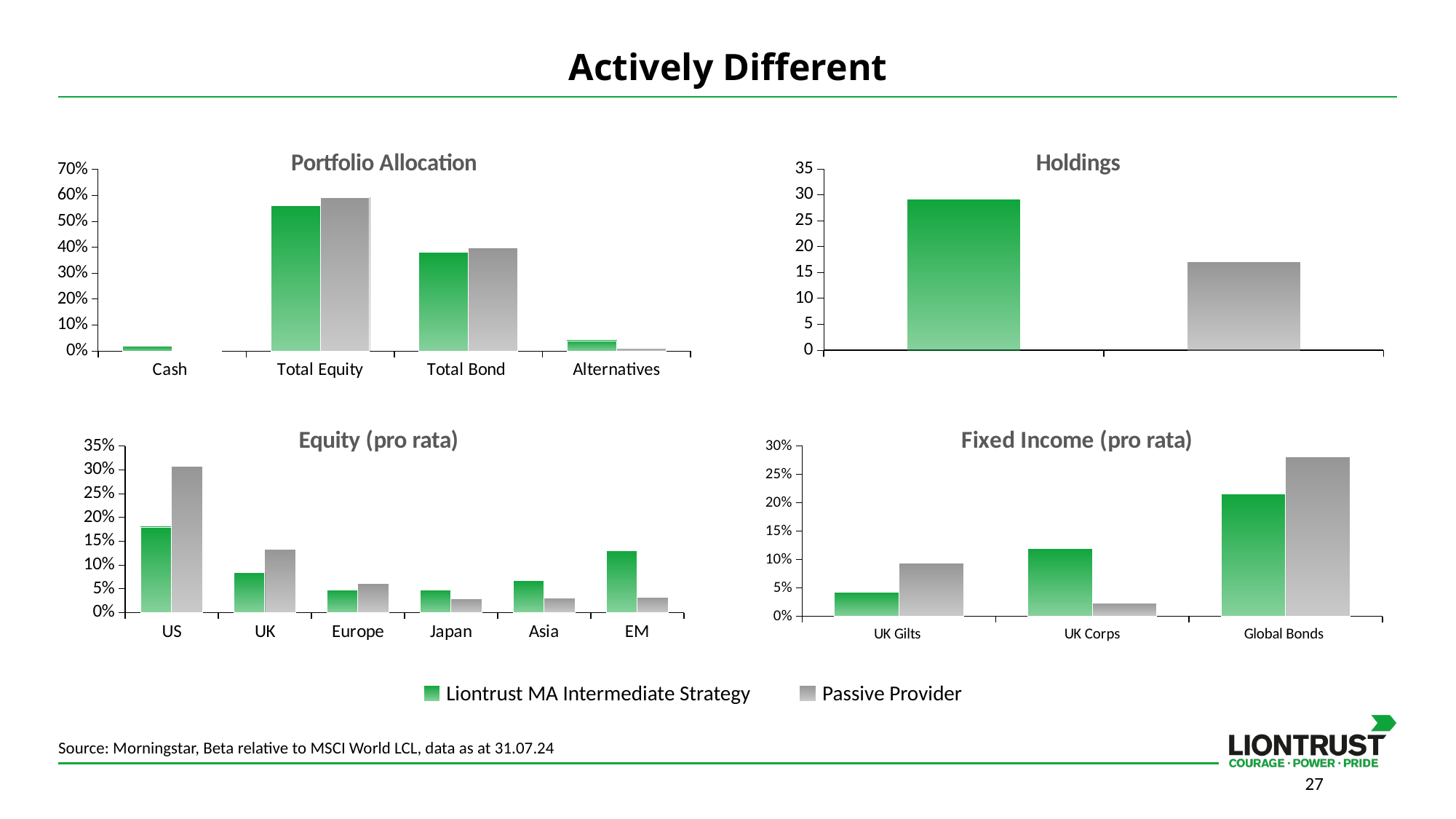
How many series does the shared legend at the bottom of the slide list? 2 In the Fixed Income (pro rata) chart, which is larger for UK Corps: Liontrust MA Intermediate Strategy or Passive Provider? Liontrust MA Intermediate Strategy In the Holdings chart, which series has the larger value: Liontrust MA Intermediate Strategy or Passive Provider? Liontrust MA Intermediate Strategy In the Portfolio Allocation chart, which is larger for Alternatives: Liontrust MA Intermediate Strategy or Passive Provider? Liontrust MA Intermediate Strategy In the Holdings chart, is the value for Liontrust MA Intermediate Strategy greater or less than 25? greater In the Equity (pro rata) chart, which region has the highest Passive Provider value? US In the Portfolio Allocation chart, is the Passive Provider value for Total Equity greater or less than 50%? greater In the Fixed Income (pro rata) chart, which category has the highest value for Liontrust MA Intermediate Strategy? Global Bonds In the Portfolio Allocation chart, which category has the highest value for Liontrust MA Intermediate Strategy? Total Equity In the Portfolio Allocation chart, how many categories are shown on the x axis? 4 In the Equity (pro rata) chart, how many regions are shown on the x axis? 6